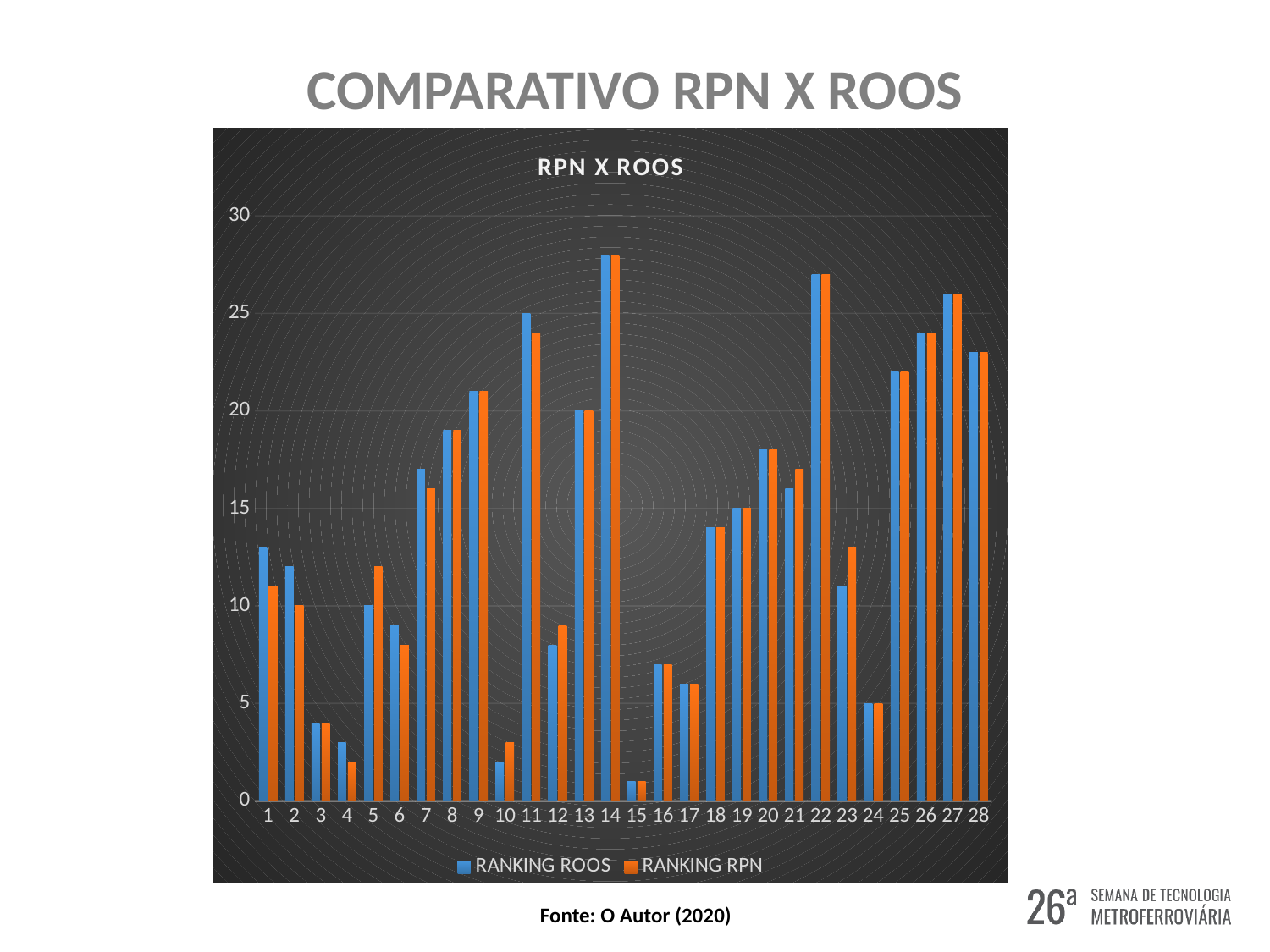
What is the RANKING ROOS value for category 13? 20 For category 23, which series has the larger value, RANKING ROOS or RANKING RPN? RANKING RPN How many categories are shown along the x axis? 28 For category 1, which series has the larger value, RANKING ROOS or RANKING RPN? RANKING ROOS Is the RANKING ROOS value for category 14 greater or less than 25? greater What is the title printed inside the chart area? RPN X ROOS What is the RANKING RPN value for category 19? 15 Which series is drawn in orange? RANKING RPN Is the RANKING RPN value for category 15 greater or less than 5? less What is the RANKING ROOS value for category 24? 5 What kind of chart is shown on the slide? bar chart How many series does the legend list? 2